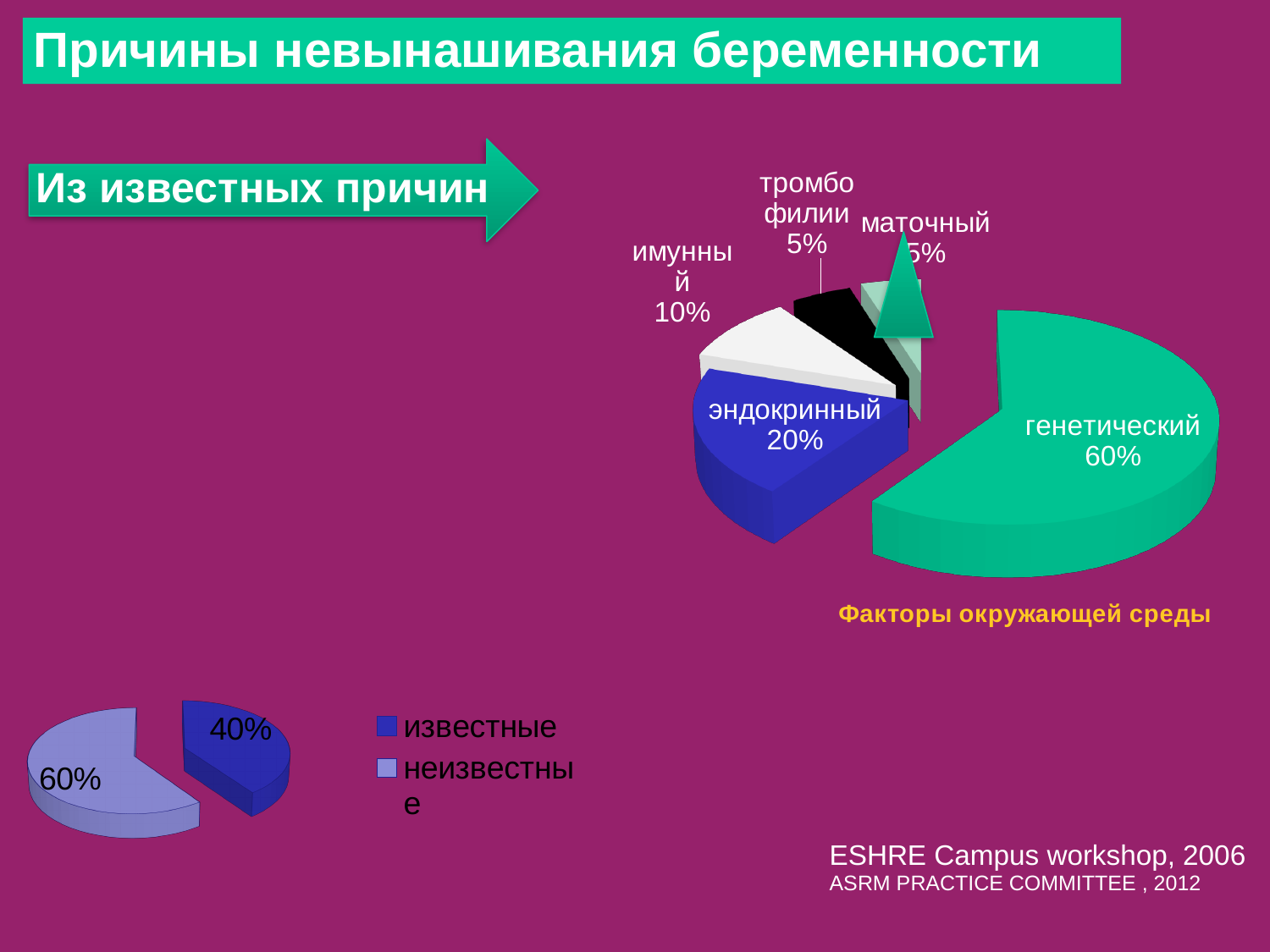
In the pie chart at the upper right of the slide, what share is labelled имунный? 10% In the pie chart at the lower left of the slide, how many entries does the legend list? 2 In the pie chart at the upper right of the slide, what is the difference between the генетический and эндокринный shares? 40% In the pie chart at the upper right of the slide, which category has the largest share? генетический In the pie chart at the lower left of the slide, what share is shown for известные? 40% In the pie chart at the upper right of the slide, what share is labelled эндокринный? 20% In the pie chart at the upper right of the slide, which is larger, эндокринный or имунный? эндокринный In the pie chart at the upper right of the slide, how many slices are labelled? 5 What kind of chart is shown at the lower left of the slide? pie chart In the pie chart at the upper right of the slide, what share is labelled генетический? 60% In the pie chart at the upper right of the slide, what share is labelled тромбофилии? 5% In the pie chart at the lower left of the slide, what share is shown for неизвестные? 60%